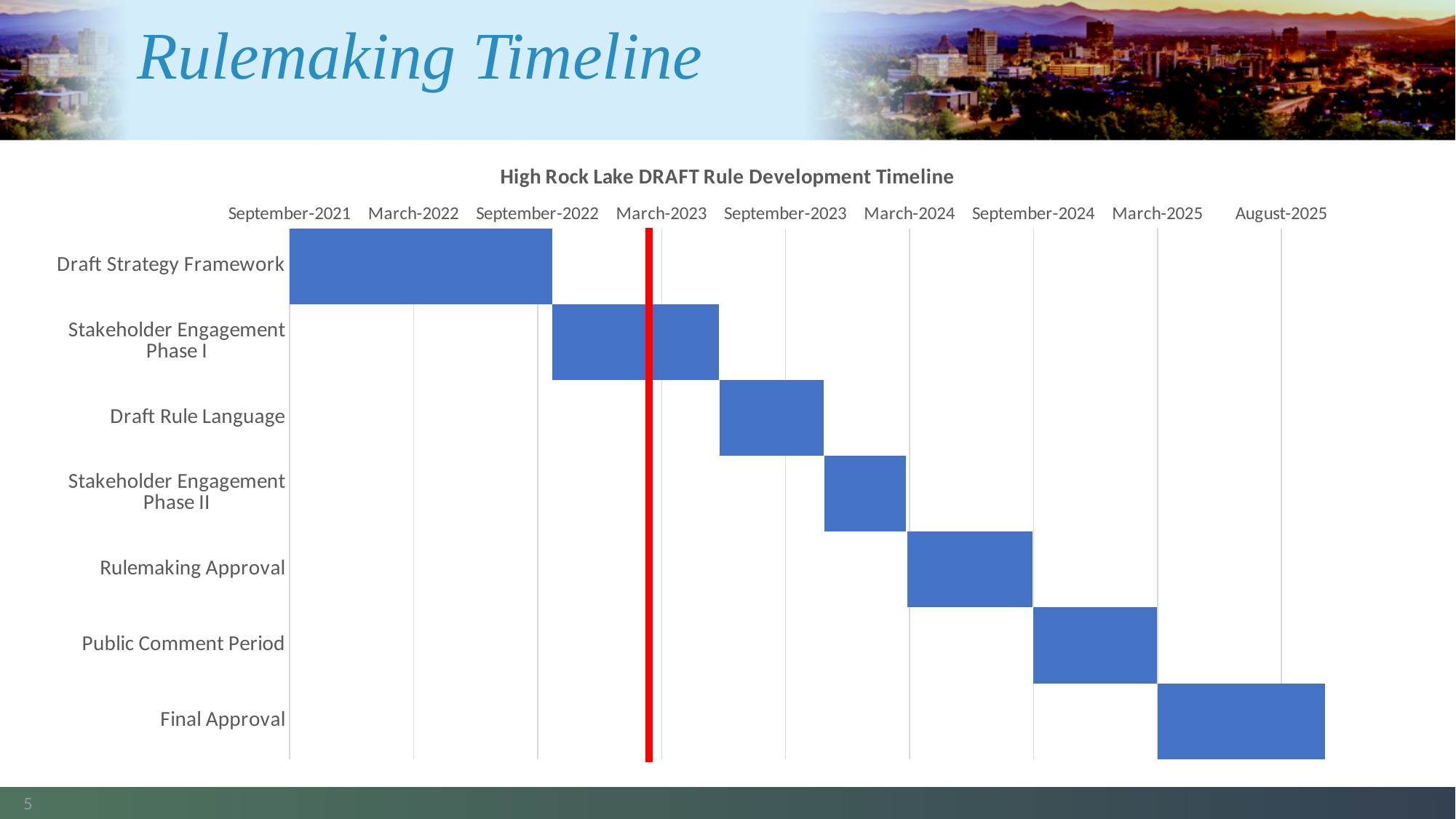
When does the Rulemaking Approval bar begin? March-2024 When does the Draft Strategy Framework bar end on the time axis? September-2022 What is the title of the chart? High Rock Lake DRAFT Rule Development Timeline When does the Draft Strategy Framework bar begin on the time axis? September-2021 When does the Public Comment Period bar end? March-2025 Which task has the longest bar in the chart? Draft Strategy Framework What kind of chart is shown on the slide? Bar chart (Gantt chart) When does the Final Approval bar end? August-2025 Between which two axis labels does the red vertical line fall? September-2022 and March-2023 Which task is scheduled last in the timeline? Final Approval Which bar is longer: Draft Strategy Framework or Draft Rule Language? Draft Strategy Framework How many tasks (categories) are listed on the vertical axis of the chart? 7